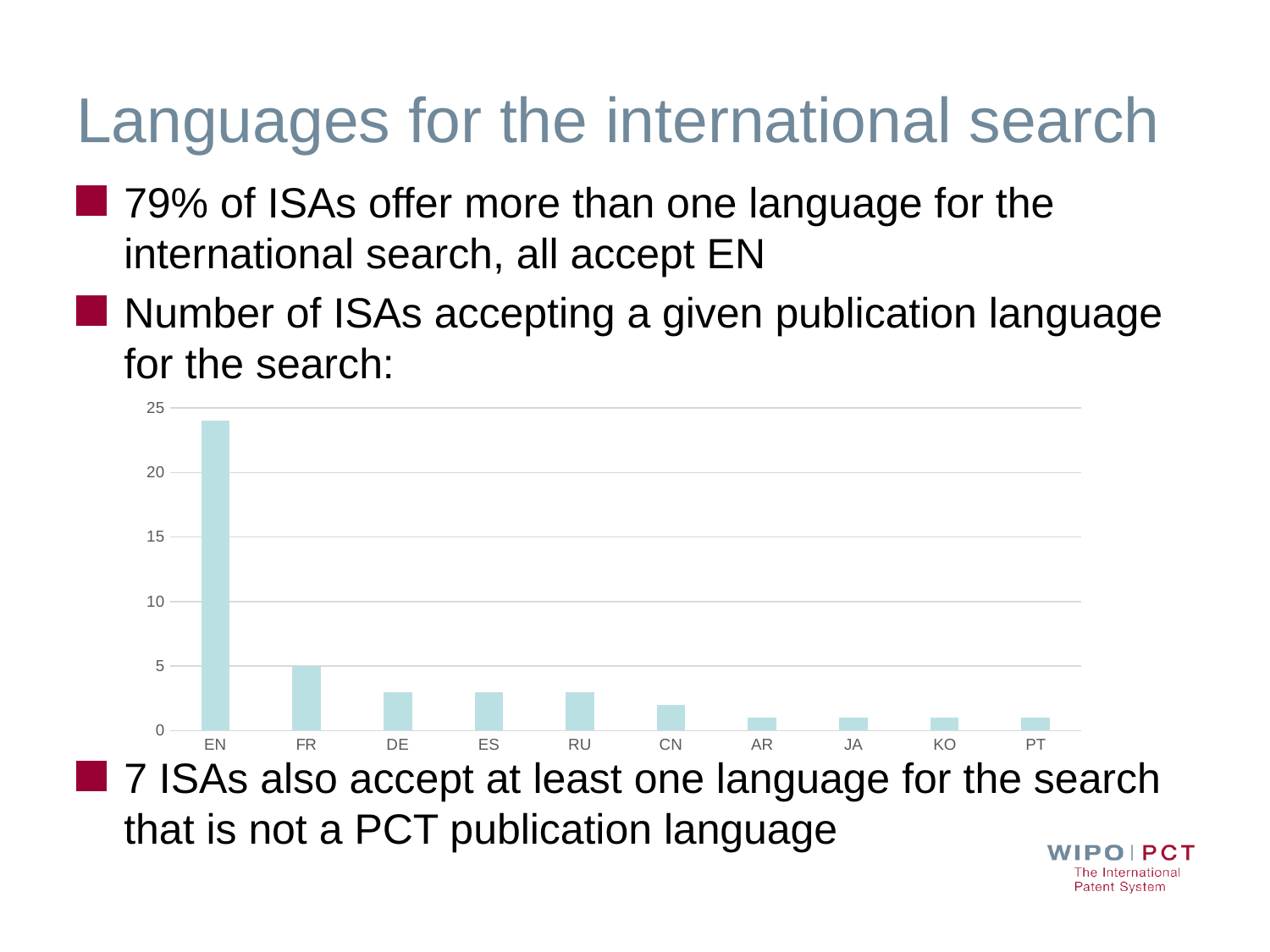
What kind of chart is shown on the slide? bar chart Is the value for AR greater or less than 5? less Which language has the highest number of ISAs accepting it for the search? EN Do the values generally rise or fall from left to right along the x axis? fall How many ISAs accept FR for the search? 5 Is the value for DE greater or less than 5? less Is the value for CN greater or less than 5? less Which has more ISAs accepting it, FR or DE? FR Which has more ISAs accepting it, EN or FR? EN What is the highest value shown on the chart's vertical axis? 25 How many languages are shown on the x axis of the chart? 10